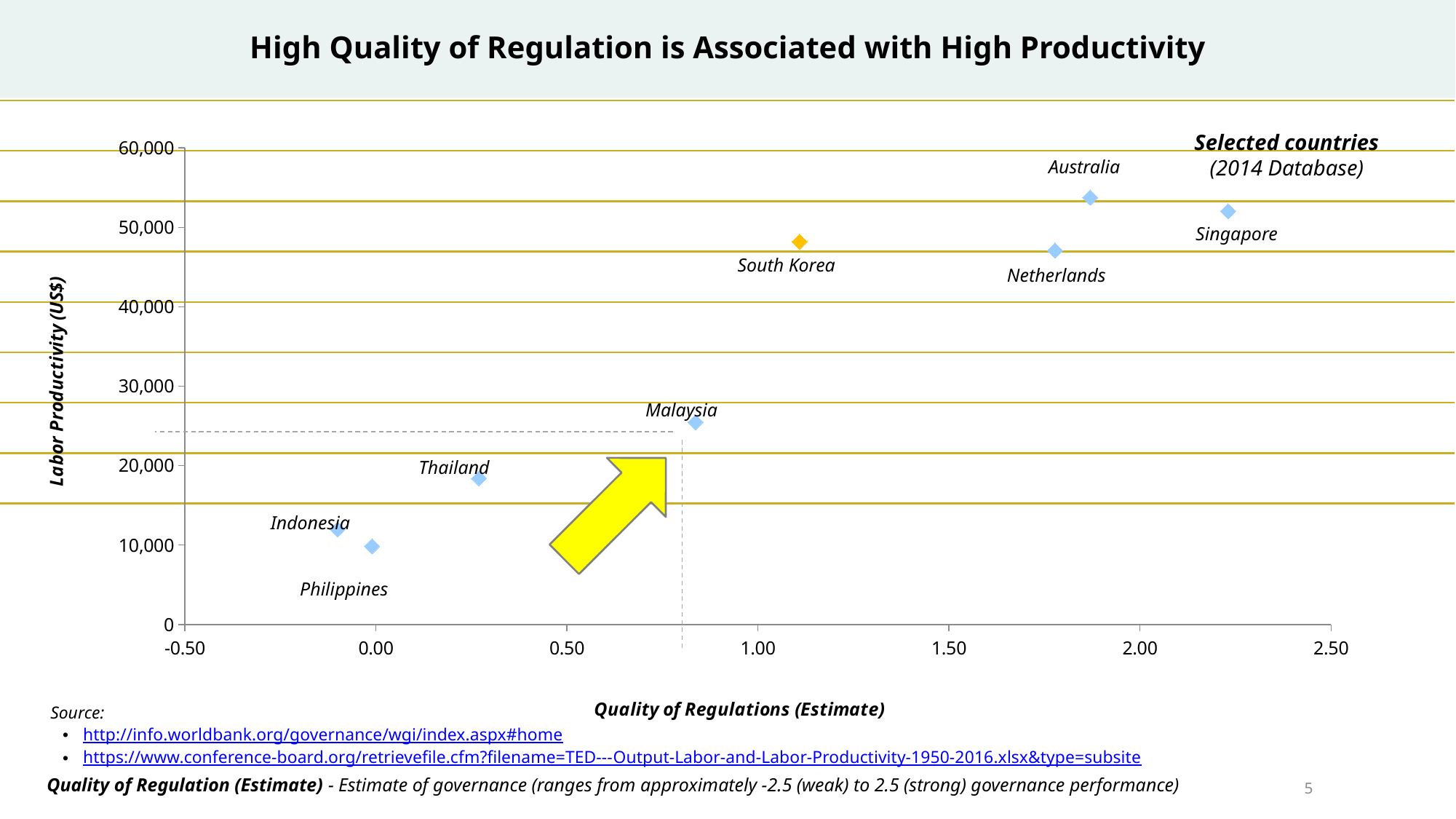
Is the labor productivity value for Australia greater or less than 50,000? greater What kind of chart is shown on the slide? scatter chart Is the labor productivity value for Thailand greater or less than 20,000? less Which has higher labor productivity, Australia or Netherlands? Australia How many countries are plotted on the chart? 8 Do labor productivity values generally rise or fall as the quality of regulations estimate increases along the x axis? rise Is the labor productivity value for Malaysia greater or less than 20,000? greater Which country has the lowest labor productivity on the chart? Philippines Which country's point is highlighted in orange on the chart? South Korea Which country has the highest labor productivity on the chart? Australia Which has higher labor productivity, Malaysia or Thailand? Malaysia